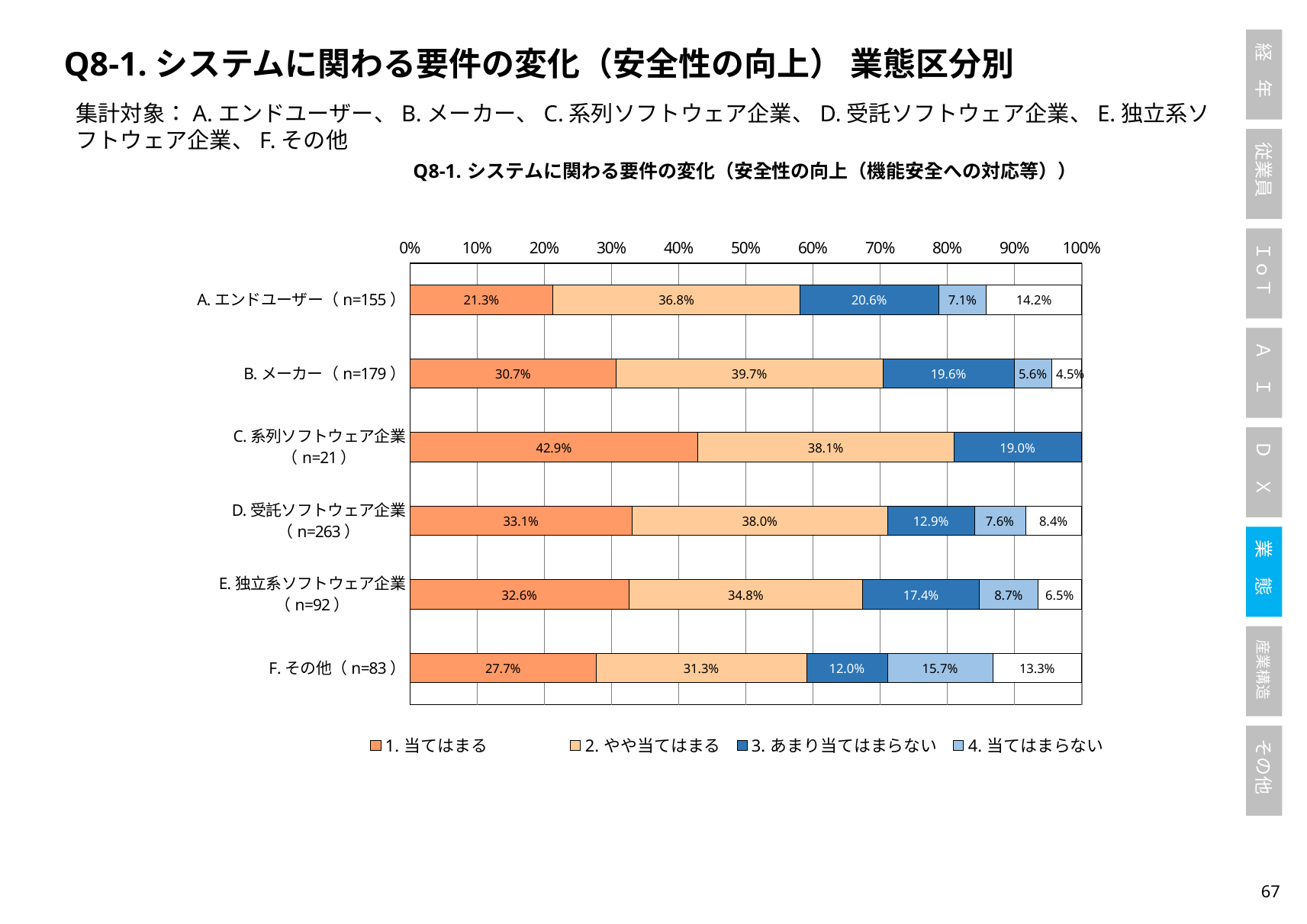
Which category has the highest value for 「1. 当てはまる」? C. 系列ソフトウェア企業 (n=21) What is the value of 「1. 当てはまる」 for C. 系列ソフトウェア企業 (n=21)? 42.9% What is the difference between the 「1. 当てはまる」 values for B. メーカー and A. エンドユーザー? 9.4% What is the value of 「3. あまり当てはまらない」 for F. その他 (n=83)? 12.0% What type of chart is shown on the slide? Stacked bar chart What is the value of 「2. やや当てはまる」 for B. メーカー (n=179)? 39.7% How many categories (業態区分) are plotted on the chart? 6 What is the value of 「4. 当てはまらない」 for E. 独立系ソフトウェア企業 (n=92)? 8.7% Which category has the lowest value for 「1. 当てはまる」? A. エンドユーザー (n=155) How many series does the legend list? 4 What is the combined share of 「1. 当てはまる」 and 「2. やや当てはまる」 for D. 受託ソフトウェア企業 (n=263)? 71.1% Which is larger: the 「4. 当てはまらない」 value for F. その他 or for D. 受託ソフトウェア企業? F. その他